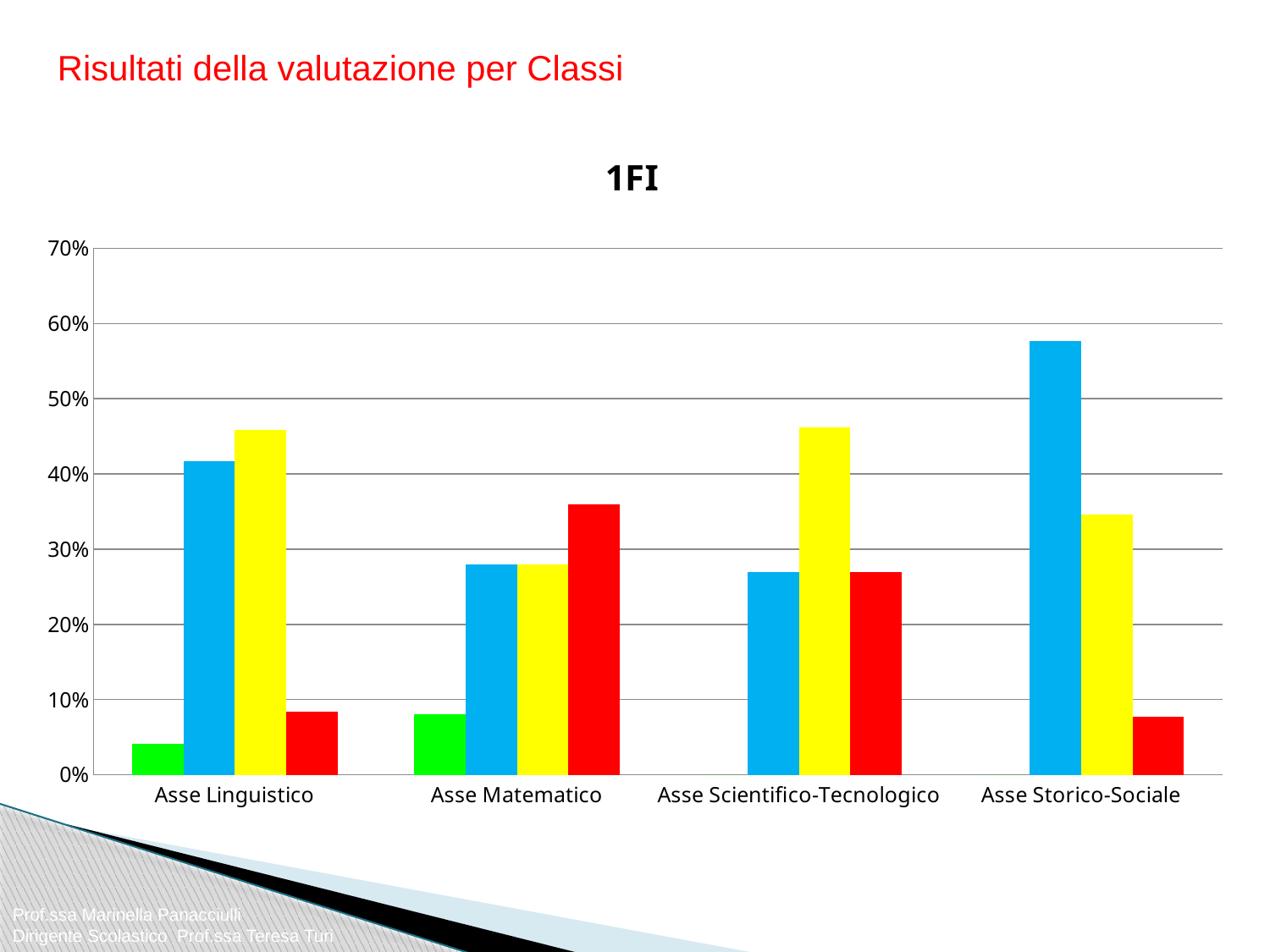
Is the value of the red bar for Asse Matematico greater or less than 30%? greater How many categories are shown on the x axis of the chart? 4 Within Asse Matematico, which coloured bar is the highest? red Is the value of the blue bar for Asse Storico-Sociale greater or less than 50%? greater Is the value of the red bar for Asse Storico-Sociale greater or less than 10%? less Which category has the tallest bar in the chart? Asse Storico-Sociale What is the title of the chart? 1FI Which is larger: the blue bar for Asse Linguistico or the blue bar for Asse Matematico? Asse Linguistico What kind of chart is shown on the slide? bar chart Which categories include a green bar? Asse Linguistico and Asse Matematico